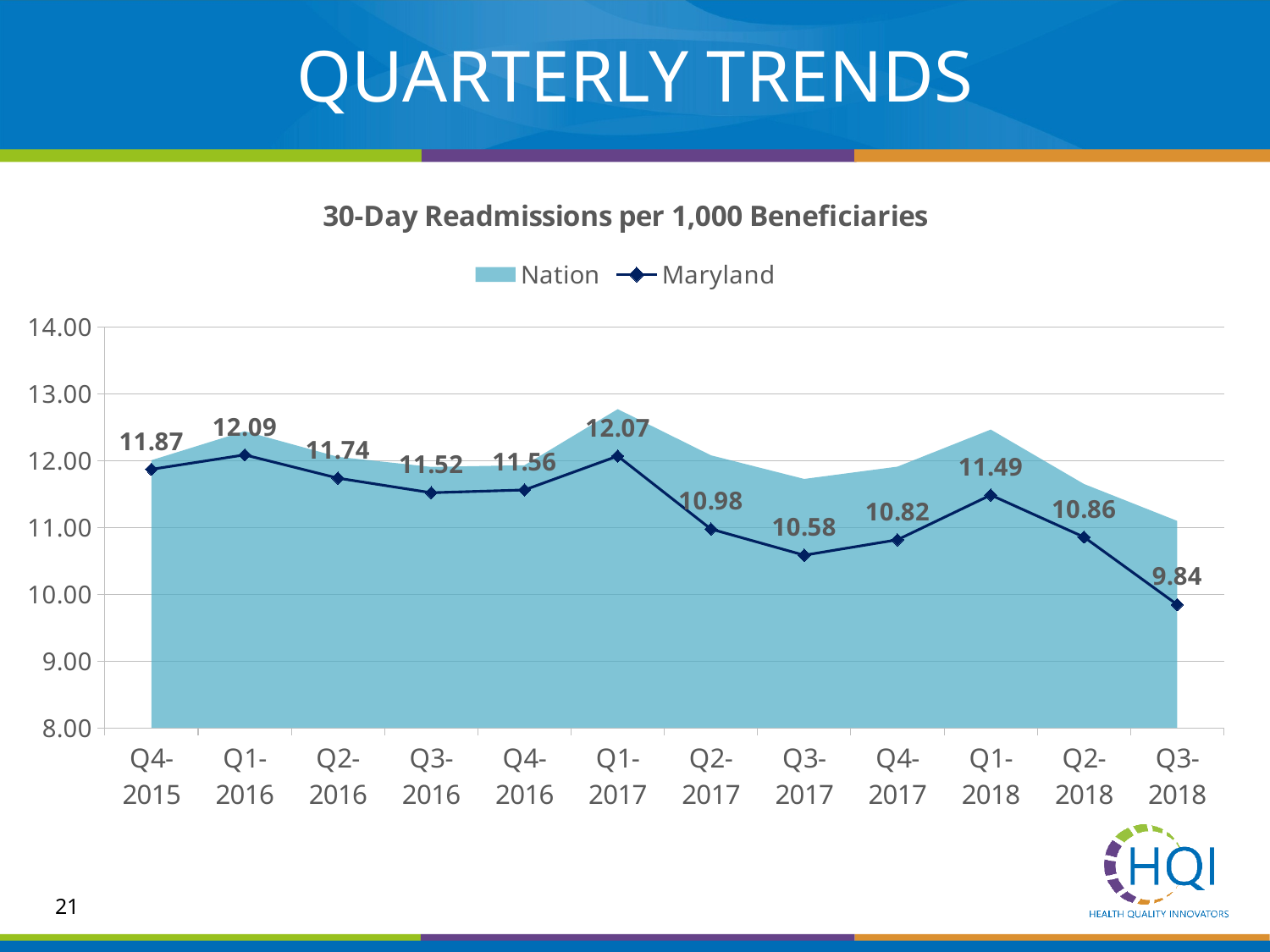
How many quarters are shown on the x axis? 12 How many series does the legend list? 2 Is the Nation value for Q3-2017 greater or less than 11.00? greater Is the Nation value for Q1-2017 greater or less than 12.00? greater What is the Maryland value for Q3-2018? 9.84 In which quarter is the Maryland value lowest? Q3-2018 What is the Maryland value for Q1-2017? 12.07 Does the Maryland value rise or fall from Q1-2018 to Q3-2018? fall What is the difference between the Maryland values for Q1-2016 and Q3-2018? 2.25 What is the Maryland value for Q4-2015? 11.87 Which is larger, the Maryland value for Q1-2017 or for Q2-2017? Q1-2017 What is the difference between the Maryland values for Q2-2017 and Q3-2017? 0.40